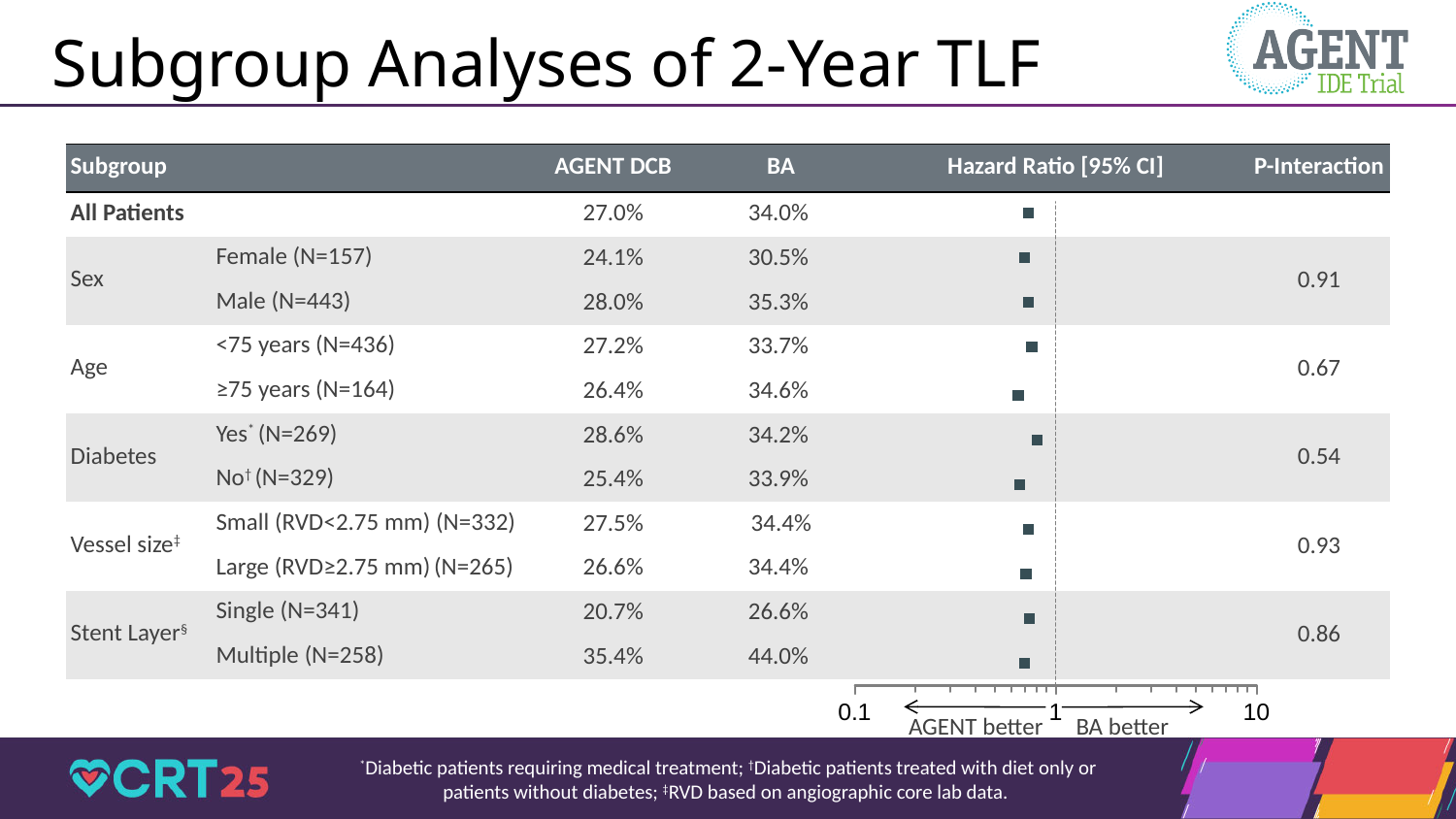
Is the hazard ratio point for Yes* (N=269) diabetes greater or less than 1? less What is the 2-year TLF rate for AGENT DCB in All Patients? 27.0% Which subgroup has the lowest BA TLF rate? Single (N=341) Which subgroup has the highest AGENT DCB TLF rate? Multiple (N=258) Is the hazard ratio point for All Patients greater or less than 1? less What is the difference between the BA and AGENT DCB TLF rates for Single (N=341) stent layer? 5.9% Is the hazard ratio point for Multiple (N=258) stent layers greater or less than 1? less What kind of chart is shown in the Hazard Ratio [95% CI] column? forest plot Which side of the hazard ratio axis is labelled 'AGENT better'? left What are the lowest and highest tick values labelled on the hazard ratio axis? 0.1 and 10 What is the 2-year TLF rate for BA in the Multiple (N=258) stent layer subgroup? 44.0% How many subgroup rows have a hazard ratio point plotted in the forest plot? 11